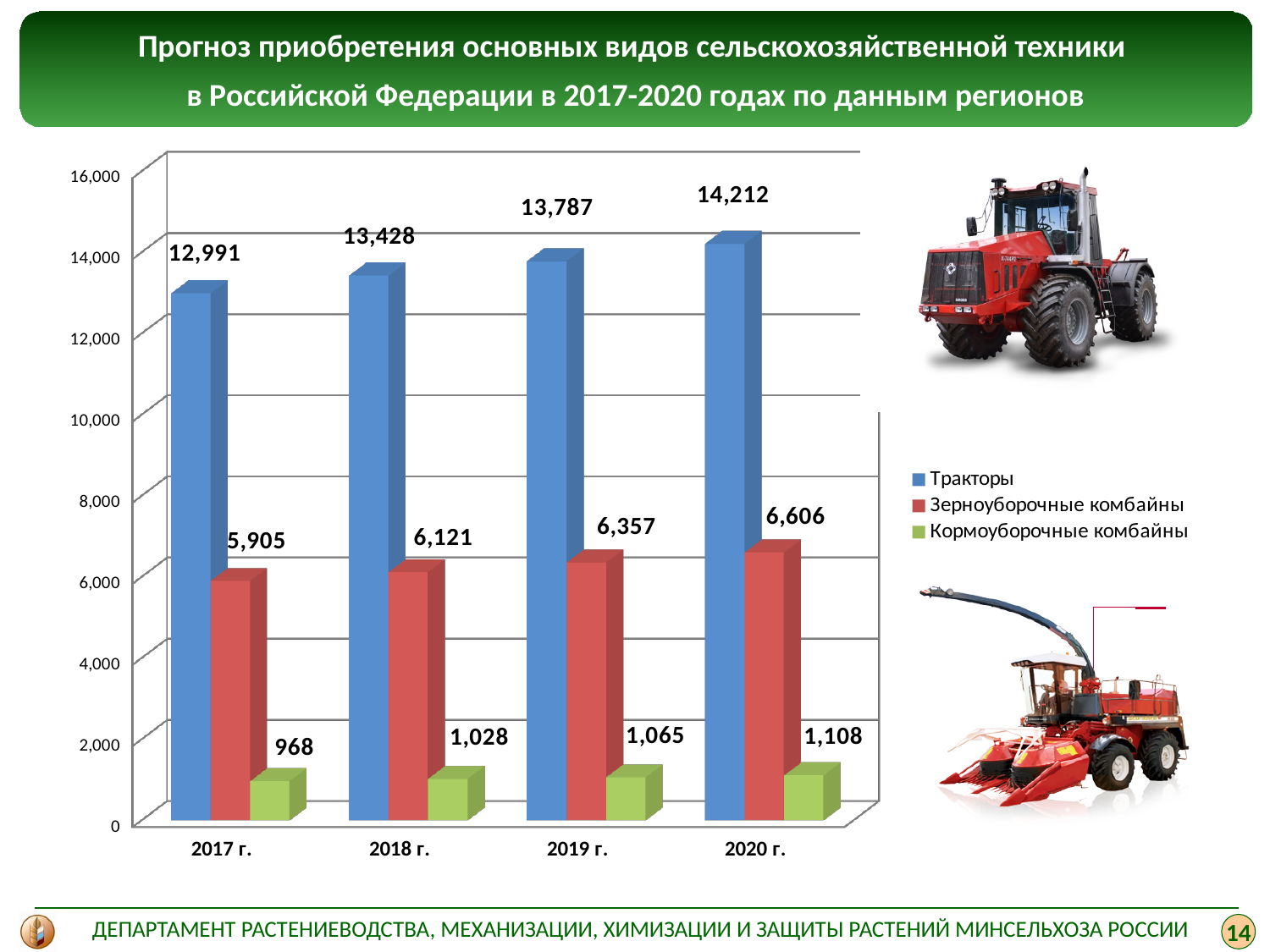
What is the value for Кормоуборочные комбайны in 2020 г.? 1,108 How many years (categories) are shown on the x axis? 4 What is the forecast value for Тракторы in 2017 г.? 12,991 What is the value for Зерноуборочные комбайны in 2019 г.? 6,357 Which colour represents Тракторы in the legend? blue Do the values for Зерноуборочные комбайны rise or fall from 2017 г. to 2020 г.? rise In which year is the value for Тракторы the highest? 2020 г. What is the difference between the Тракторы values for 2020 г. and 2017 г.? 1,221 Which is larger: Зерноуборочные комбайны in 2018 г. or Зерноуборочные комбайны in 2020 г.? 2020 г. How many series does the legend list? 3 In which year is the value for Кормоуборочные комбайны the lowest? 2017 г. What kind of chart is shown on the slide? bar chart